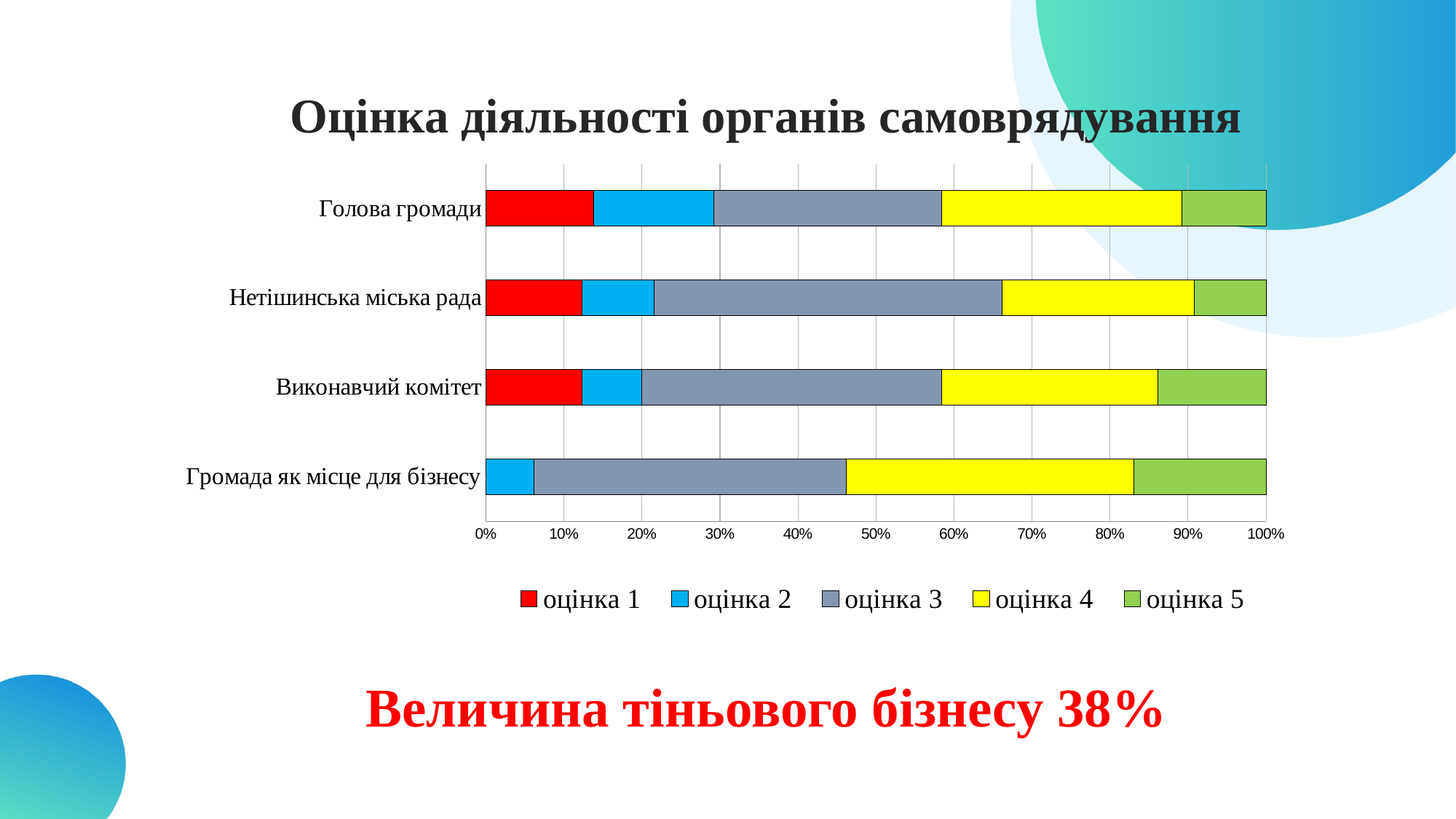
Which category has no оцінка 1 segment in its bar? Громада як місце для бізнесу Is the value for оцінка 3 for Нетішинська міська рада greater or less than 40%? greater What is the total of the stacked bar for Виконавчий комітет? 100% Which is larger: the оцінка 3 segment for Громада як місце для бізнесу or for Голова громади? Громада як місце для бізнесу Is the value for оцінка 4 for Громада як місце для бізнесу greater or less than 30%? greater Which is larger: the оцінка 2 segment for Голова громади or for Виконавчий комітет? Голова громади How many categories are shown on the chart's vertical axis? 4 How many series does the legend list? 5 What is the title of the chart? Оцінка діяльності органів самоврядування Is the value for оцінка 1 for Голова громади greater or less than 10%? greater What kind of chart is shown on the slide? Stacked bar chart